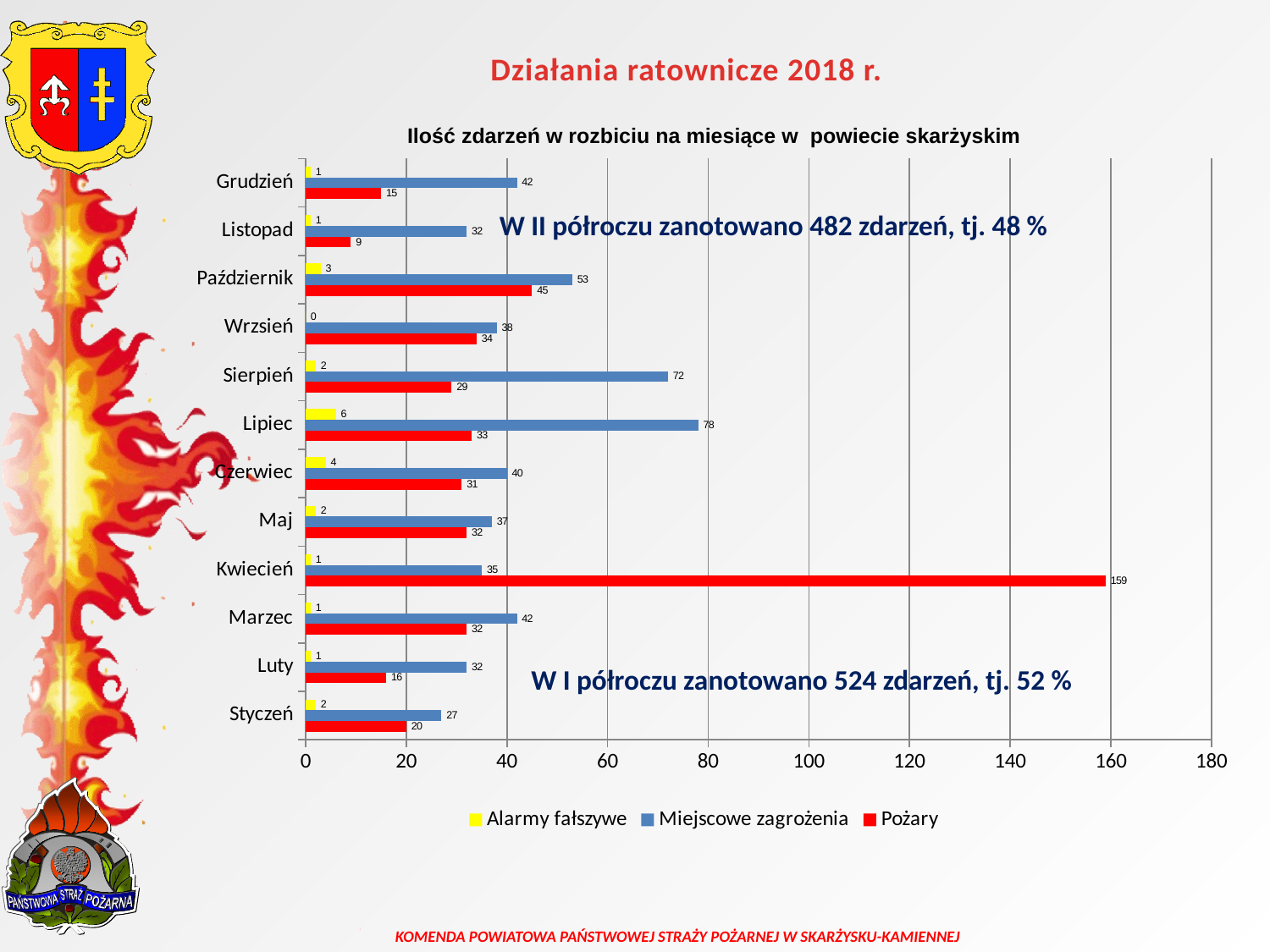
How many months are shown on the chart? 12 Which month has the highest value for Miejscowe zagrożenia? Lipiec How many series does the legend list? 3 Which month has the lowest value for Pożary? Listopad What is the value of Miejscowe zagrożenia for Lipiec? 78 What is the difference between Miejscowe zagrożenia and Pożary for Grudzień? 27 Which is larger for Październik: Miejscowe zagrożenia or Pożary? Miejscowe zagrożenia What type of chart is shown on the slide? Bar chart Which month has the highest value for Pożary? Kwiecień What is the value of Alarmy fałszywe for Wrzsień? 0 Is the value of Pożary for Kwiecień greater or less than 140? greater What is the value of Pożary for Kwiecień? 159